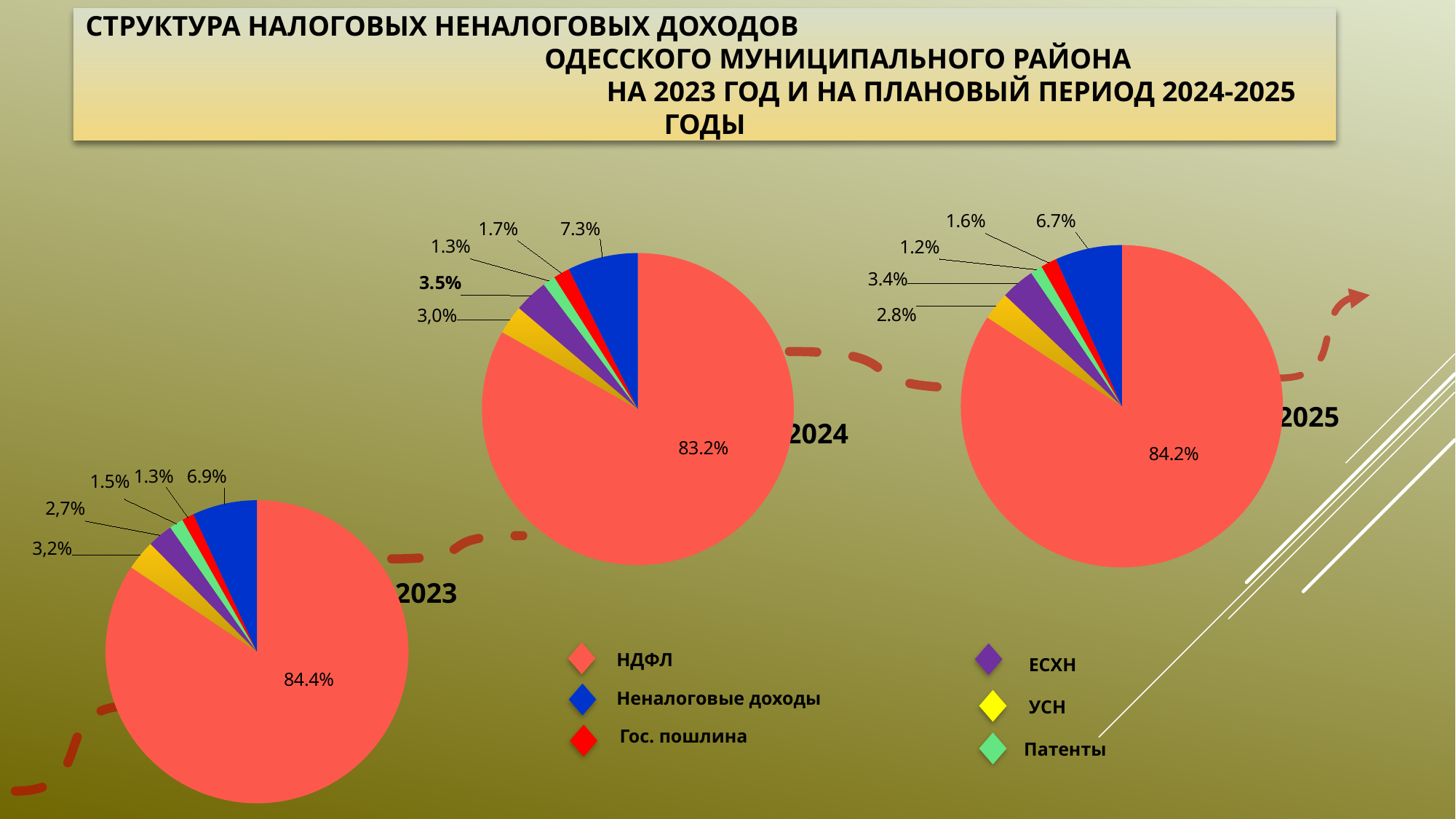
In the 2023 pie chart, what share does НДФЛ have? 84.4% In the 2024 pie chart, what share does НДФЛ have? 83.2% In the 2025 pie chart, what is the share of ЕСХН? 3.4% In the 2023 pie chart, which category has the largest share? НДФЛ In the 2025 pie chart, which category has the smallest share? Патенты In the 2024 pie chart, what is the share of Неналоговые доходы? 7.3% In the 2024 pie chart, which is larger: the share of ЕСХН or the share of УСН? ЕСХН In the 2025 pie chart, what share does НДФЛ have? 84.2% What type of charts are shown on the slide? Pie charts In the 2023 pie chart, what is the share of УСН? 3,2% What is the difference between the НДФЛ share in 2023 and in 2024? 1.2% How many categories does the legend list? 6